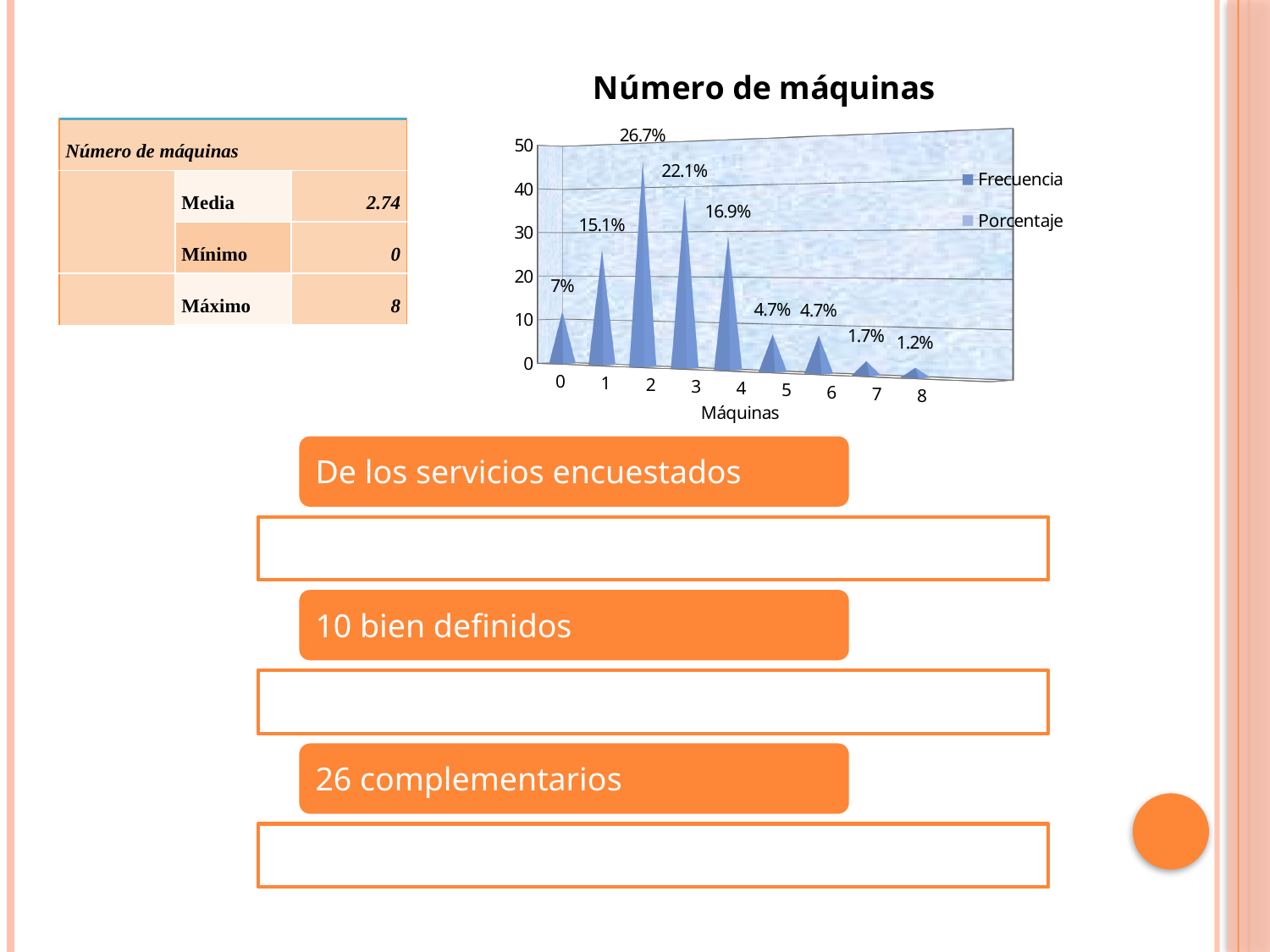
Which number of máquinas has the highest percentage label? 2 How many series does the chart legend list? 2 What is the difference between the percentage labels for 2 máquinas and 3 máquinas? 4.6 percentage points Which has a larger percentage label, 1 máquina or 4 máquinas? 4 máquinas What are the two series named in the chart legend? Frecuencia and Porcentaje What percentage label is shown for 4 máquinas? 16.9% What percentage label is shown for 0 máquinas? 7% Which number of máquinas has the lowest percentage label? 8 What is the title of the chart? Número de máquinas How many categories are shown on the x axis (Máquinas) of the chart? 9 Is the Frecuencia value for 2 máquinas greater or less than 40? greater What percentage label is shown for 2 máquinas? 26.7%